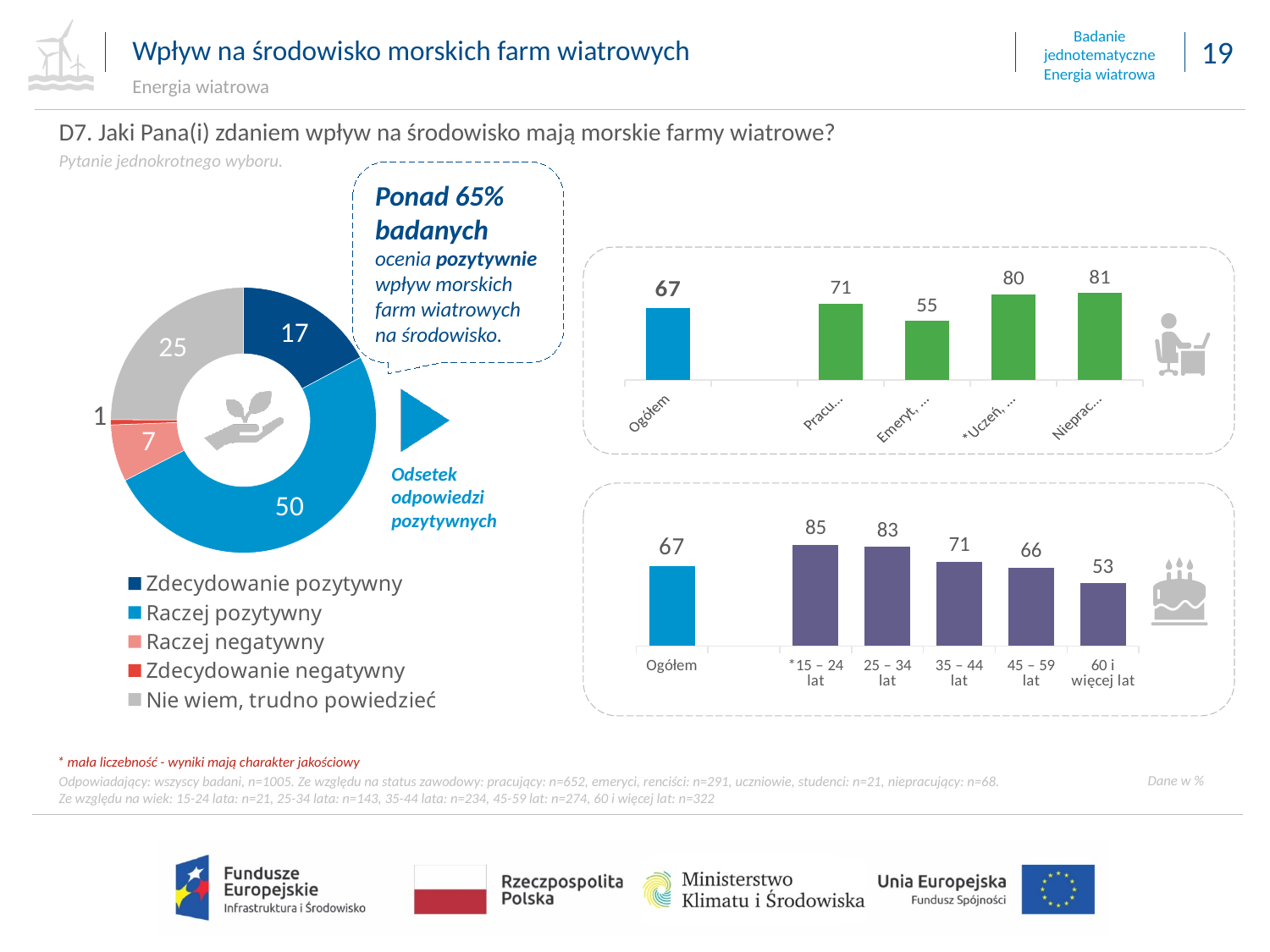
In the bottom-right bar chart by age, how many bars are shown? 6 In the bottom-right bar chart by age, what is the value for '25 – 34 lat'? 83 How many entries does the legend of the donut chart on the left list? 5 In the donut chart on the left, what value is shown for 'Nie wiem, trudno powiedzieć'? 25 In the bottom-right bar chart by age, which age group has the lowest value? 60 i więcej lat In the donut chart on the left, which response category has the smallest share? Zdecydowanie negatywny In the top-right bar chart by employment status, what is the value for 'Ogółem'? 67 In the bottom-right bar chart by age, what is the difference between the values for '35 – 44 lat' and '60 i więcej lat'? 18 In the bottom-right bar chart by age, which age group has the highest value? *15 – 24 lat In the top-right bar chart by employment status, which bar has the highest value? Nieprac… In the donut chart on the left, what percentage of respondents answered 'Raczej pozytywny'? 50 In the donut chart on the left, what is the combined value of 'Zdecydowanie pozytywny' and 'Raczej pozytywny'? 67